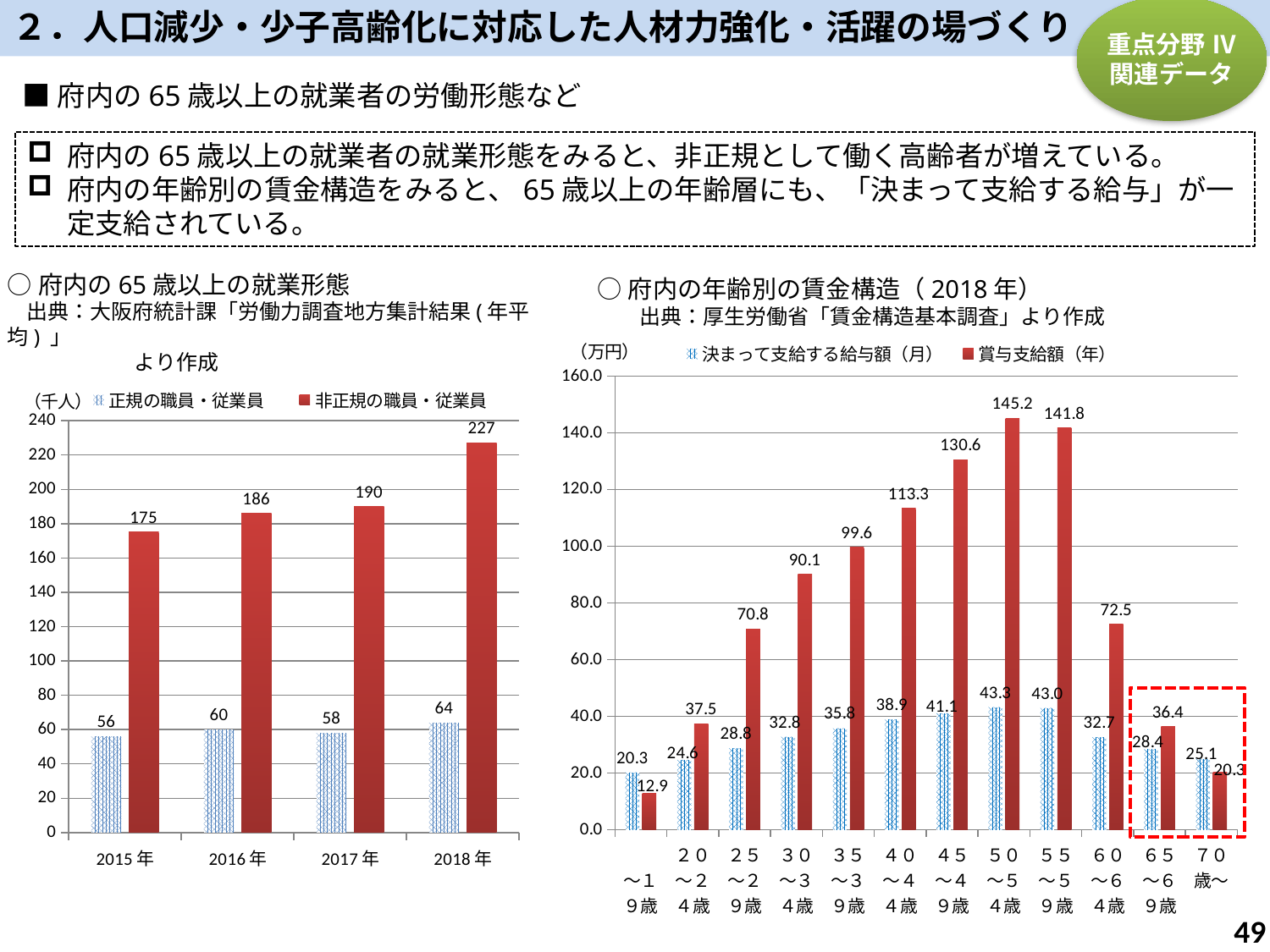
In the left chart (府内の65歳以上の就業形態), how many series does the legend list? 2 In the left chart (府内の65歳以上の就業形態), what is the value for 非正規の職員・従業員 in 2018年? 227 In the left chart (府内の65歳以上の就業形態), does the 非正規の職員・従業員 series rise or fall from 2015年 to 2018年? rise In the left chart (府内の65歳以上の就業形態), what is the value for 正規の職員・従業員 in 2016年? 60 In the left chart (府内の65歳以上の就業形態), what is the difference between 非正規の職員・従業員 and 正規の職員・従業員 in 2015年? 119 In the right chart (府内の年齢別の賃金構造), which age group has the lowest 賞与支給額（年）? ～19歳 In the left chart (府内の65歳以上の就業形態), what kind of chart is it? bar chart In the right chart (府内の年齢別の賃金構造), what is the 決まって支給する給与額（月） for 65～69歳? 28.4 In the right chart (府内の年齢別の賃金構造), which age group has the highest 賞与支給額（年）? 50～54歳 In the right chart (府内の年齢別の賃金構造), how many age groups are shown on the x axis? 12 In the right chart (府内の年齢別の賃金構造), which is larger for 60～64歳: 決まって支給する給与額（月） or 賞与支給額（年）? 賞与支給額（年） In the right chart (府内の年齢別の賃金構造), what is the 賞与支給額（年） for 70歳～? 20.3